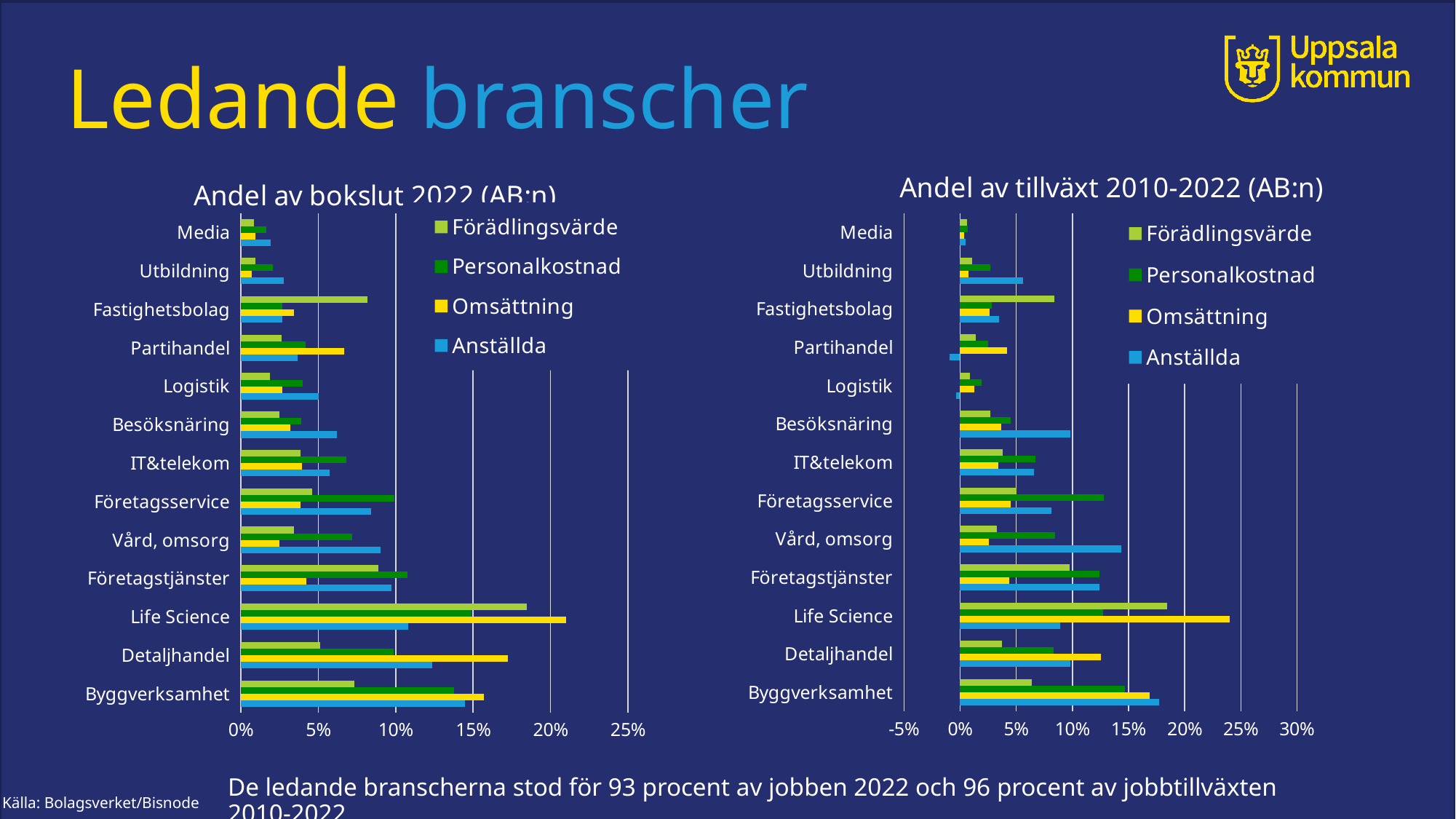
How many industry categories are shown on the left chart, 'Andel av bokslut 2022 (AB:n)'? 13 In the right chart, 'Andel av tillväxt 2010-2022 (AB:n)', is the Anställda value for Partihandel greater or less than 0%? less In the left chart, 'Andel av bokslut 2022 (AB:n)', which is larger: the Omsättning value for Detaljhandel or for Byggverksamhet? Detaljhandel In the right chart, 'Andel av tillväxt 2010-2022 (AB:n)', which is larger: the Anställda value for Byggverksamhet or for Detaljhandel? Byggverksamhet How many series does the legend of the right chart, 'Andel av tillväxt 2010-2022 (AB:n)', list? 4 In the left chart, 'Andel av bokslut 2022 (AB:n)', which category has the highest Omsättning value? Life Science In the left chart, 'Andel av bokslut 2022 (AB:n)', is the Omsättning value for Detaljhandel greater or less than 15%? greater What is the title of the right chart on the slide? Andel av tillväxt 2010-2022 (AB:n) In the right chart, 'Andel av tillväxt 2010-2022 (AB:n)', is the Omsättning value for Life Science greater or less than 20%? greater What kind of chart is the left chart, 'Andel av bokslut 2022 (AB:n)'? bar chart In the right chart, 'Andel av tillväxt 2010-2022 (AB:n)', which category has the highest Förädlingsvärde value? Life Science